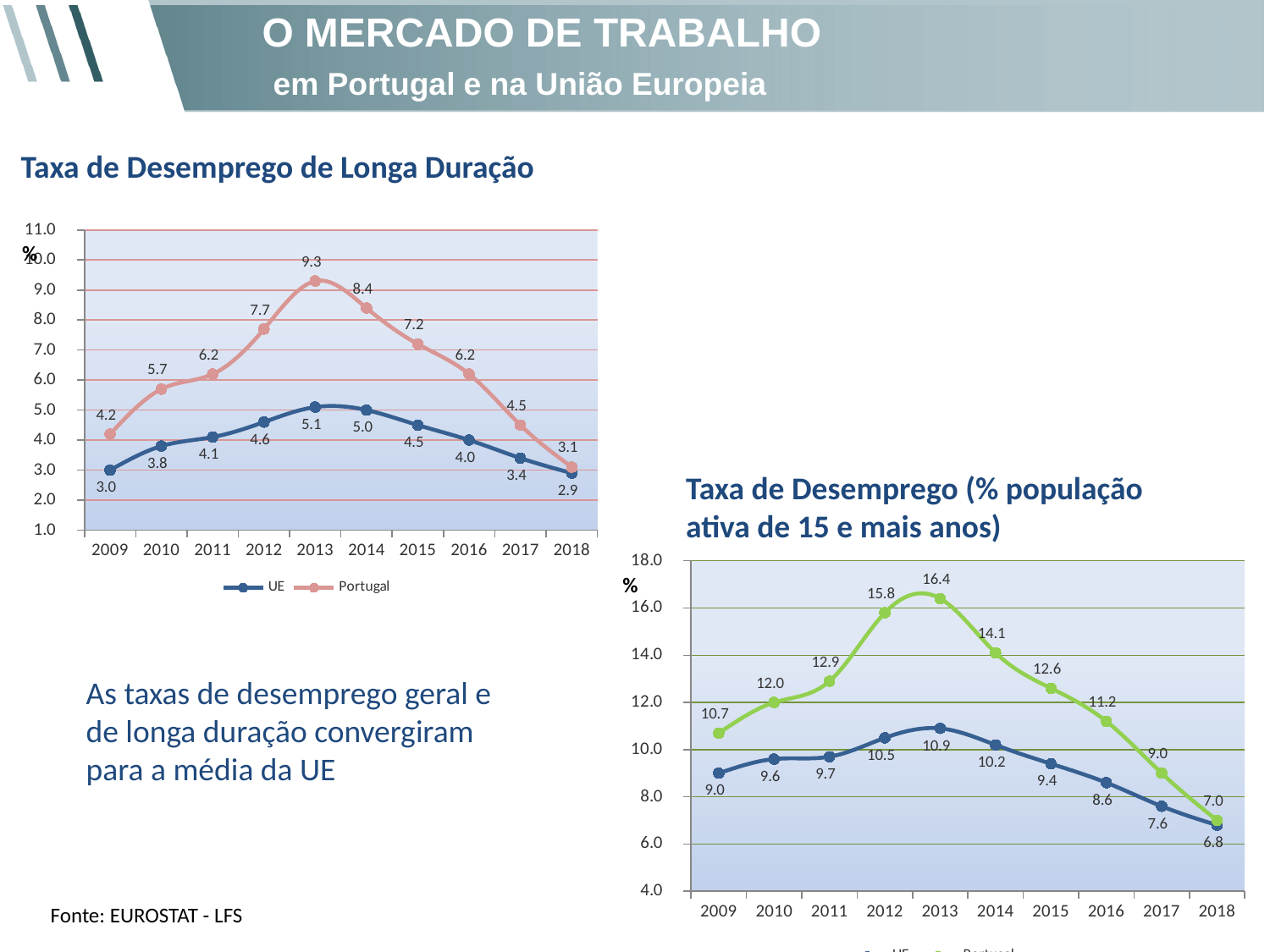
In the 'Taxa de Desemprego de Longa Duração' chart, what is the value for UE in 2018? 2.9 In the 'Taxa de Desemprego de Longa Duração' chart, how many years are shown on the x axis? 10 In the 'Taxa de Desemprego de Longa Duração' chart, what is the value for Portugal in 2013? 9.3 In the 'Taxa de Desemprego (% população ativa de 15 e mais anos)' chart, which line has the higher value in 2012, the green line or the blue line? Green line What kind of chart is the 'Taxa de Desemprego de Longa Duração' chart? Line chart In the 'Taxa de Desemprego de Longa Duração' chart, in which year is the UE series lowest? 2018 In the 'Taxa de Desemprego de Longa Duração' chart, how many series does the legend list? 2 In the 'Taxa de Desemprego (% população ativa de 15 e mais anos)' chart, what is the value of the blue line in 2009? 9.0 In the 'Taxa de Desemprego de Longa Duração' chart, in which year does the Portugal series reach its highest value? 2013 In the 'Taxa de Desemprego de Longa Duração' chart, what is the difference between Portugal and UE in 2013? 4.2 In the 'Taxa de Desemprego (% população ativa de 15 e mais anos)' chart, do the values of the green line rise or fall from 2013 to 2018? Fall In the 'Taxa de Desemprego (% população ativa de 15 e mais anos)' chart, what is the value of the green line in 2013? 16.4